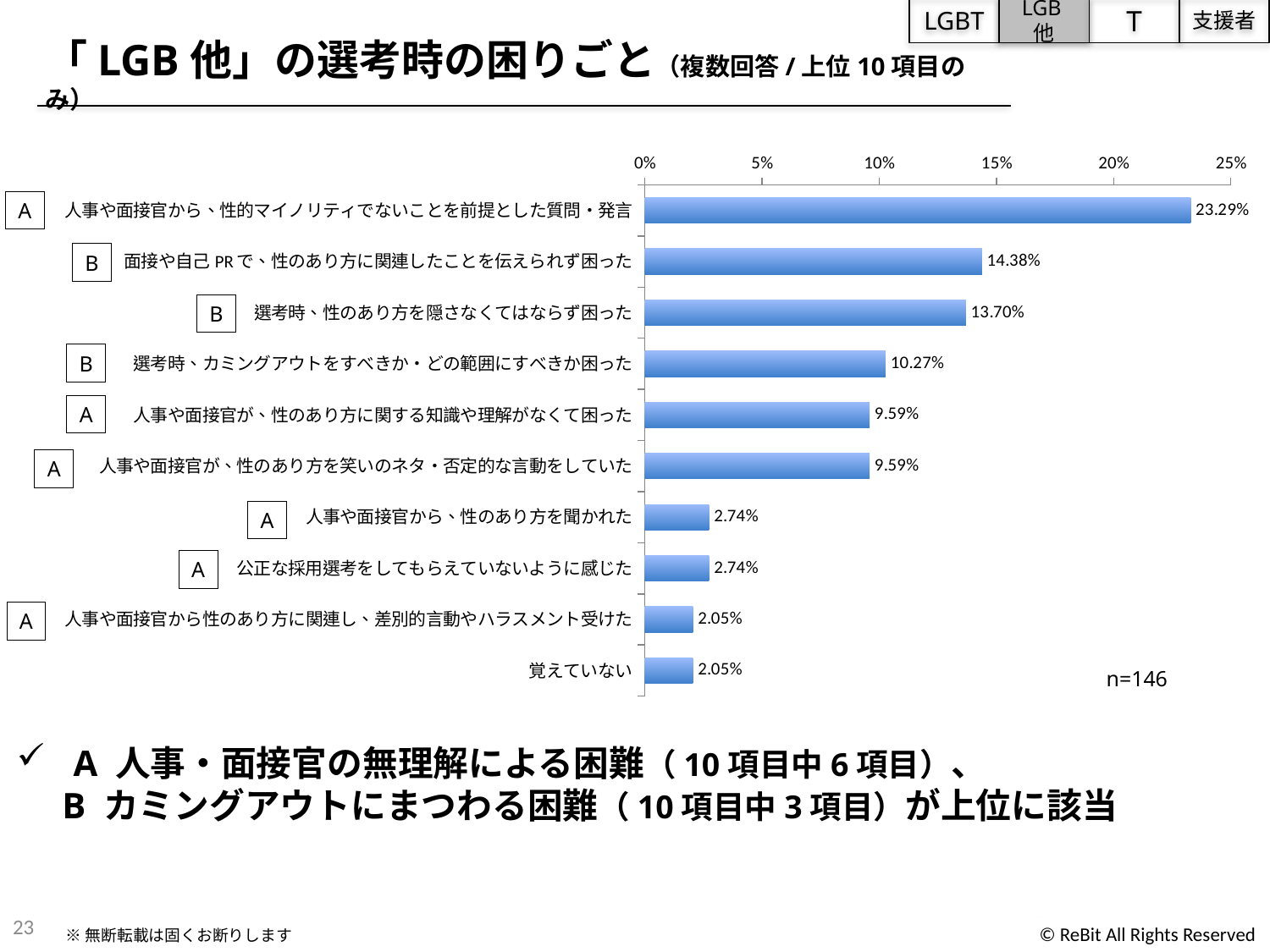
What type of chart is shown on the slide? bar chart What is the value for 「覚えていない」? 2.05% Which category has the highest value in the chart? 人事や面接官から、性的マイノリティでないことを前提とした質問・発言 What is the value for 「面接や自己PRで、性のあり方に関連したことを伝えられず困った」? 14.38% How many categories are plotted in the chart? 10 What is the difference between the highest value and the value for 「人事や面接官から、性のあり方を聞かれた」? 20.55% Which is larger: the value for 「選考時、カミングアウトをすべきか・どの範囲にすべきか困った」 or the value for 「人事や面接官が、性のあり方に関する知識や理解がなくて困った」? 選考時、カミングアウトをすべきか・どの範囲にすべきか困った What is the value for 「選考時、カミングアウトをすべきか・どの範囲にすべきか困った」? 10.27% What sample size (n) is shown next to the chart? n=146 Is the value for 「人事や面接官から、性的マイノリティでないことを前提とした質問・発言」 greater or less than 20%? greater What is the difference between the values for 「面接や自己PRで、性のあり方に関連したことを伝えられず困った」 and 「選考時、性のあり方を隠さなくてはならず困った」? 0.68% What is the value for 「人事や面接官から、性的マイノリティでないことを前提とした質問・発言」? 23.29%